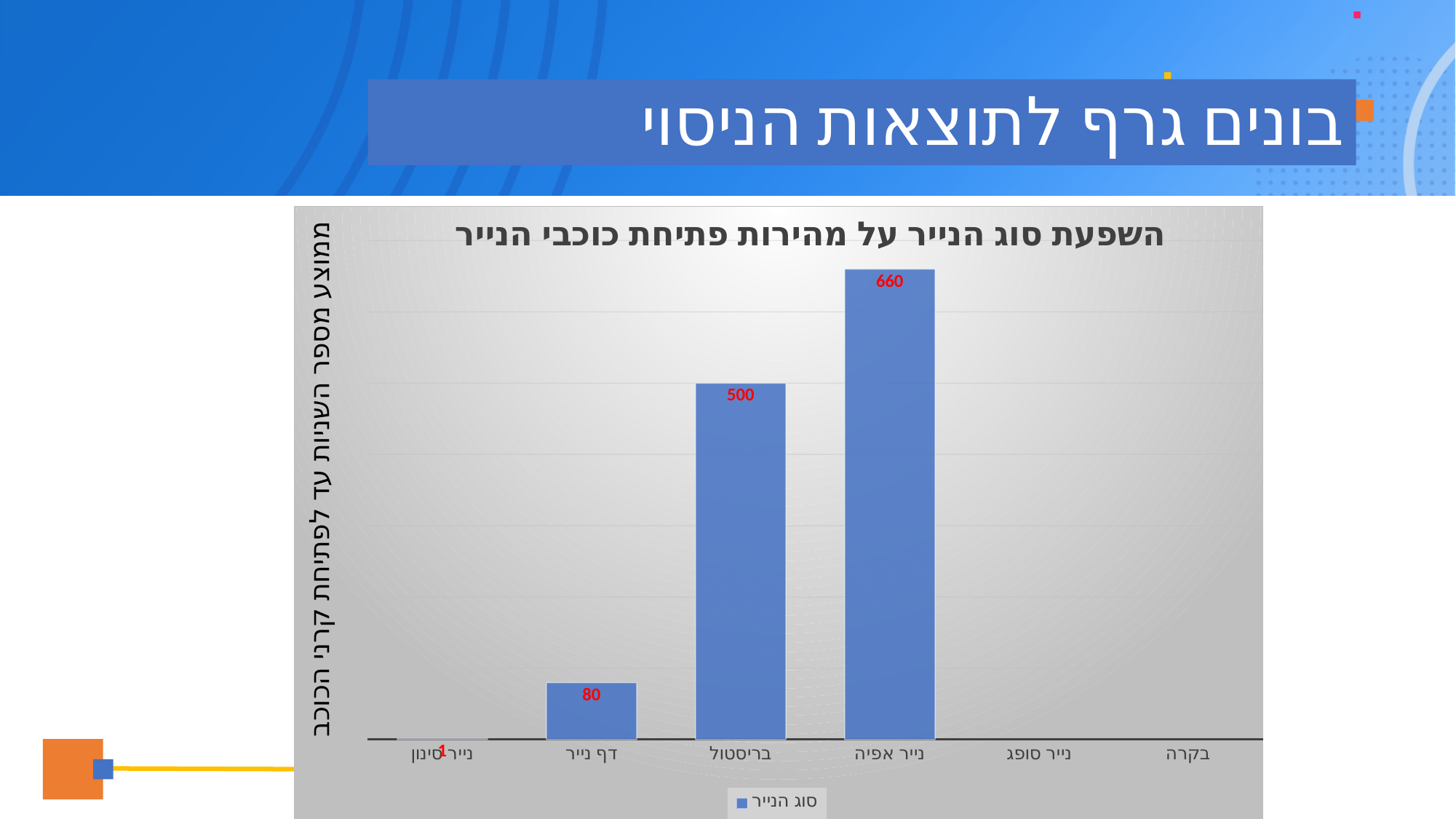
What is the difference between the values for נייר אפיה and בריסטול? 160 What is the value for בריסטול? 500 Which category has the highest value? נייר אפיה What is the difference between the values for בריסטול and דף נייר? 420 What is the title of the chart? השפעת סוג הנייר על מהירות פתיחת כוכבי הנייר What is the value for נייר אפיה? 660 What is the value for נייר סינון? 1 What is the value for דף נייר? 80 How many series does the legend list? 1 Which is larger, the value for דף נייר or the value for בריסטול? בריסטול How many categories are shown on the x axis? 6 What type of chart is shown on the slide? bar chart